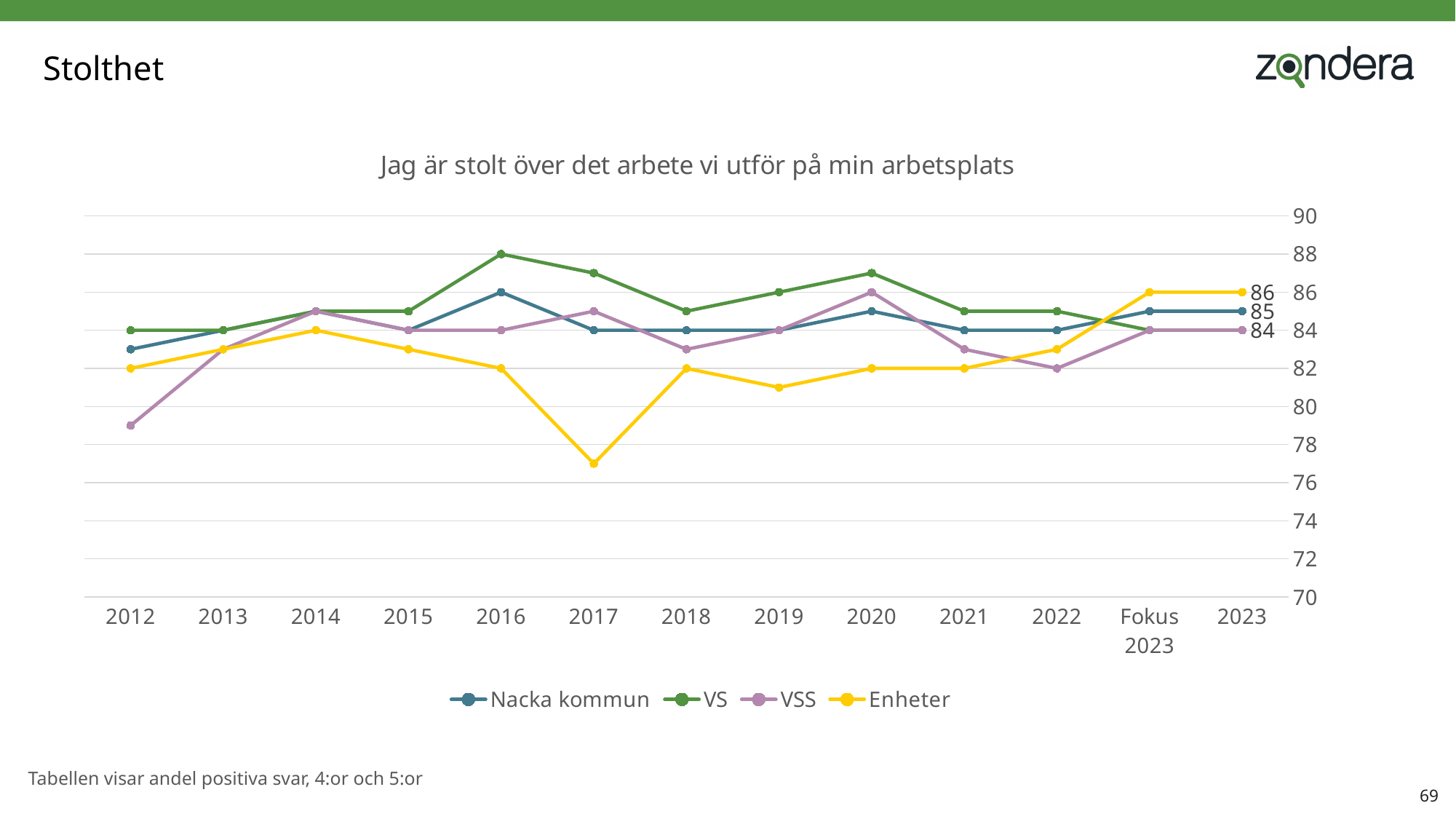
How many points are there along the x axis? 13 What is the title of the chart? Jag är stolt över det arbete vi utför på min arbetsplats What is the value for Enheter in 2023? 86 What is the value for Enheter in 2012? 82 What is the value for VSS in 2023? 84 Which series has the highest value in 2016? VS What is the value for Nacka kommun in 2023? 85 What is the value for VS in 2016? 88 Is the value for Enheter in 2017 greater or less than 78? less How many series does the legend list? 4 What is the difference between the Enheter value and the VSS value in 2023? 2 What kind of chart is shown on the slide? line chart